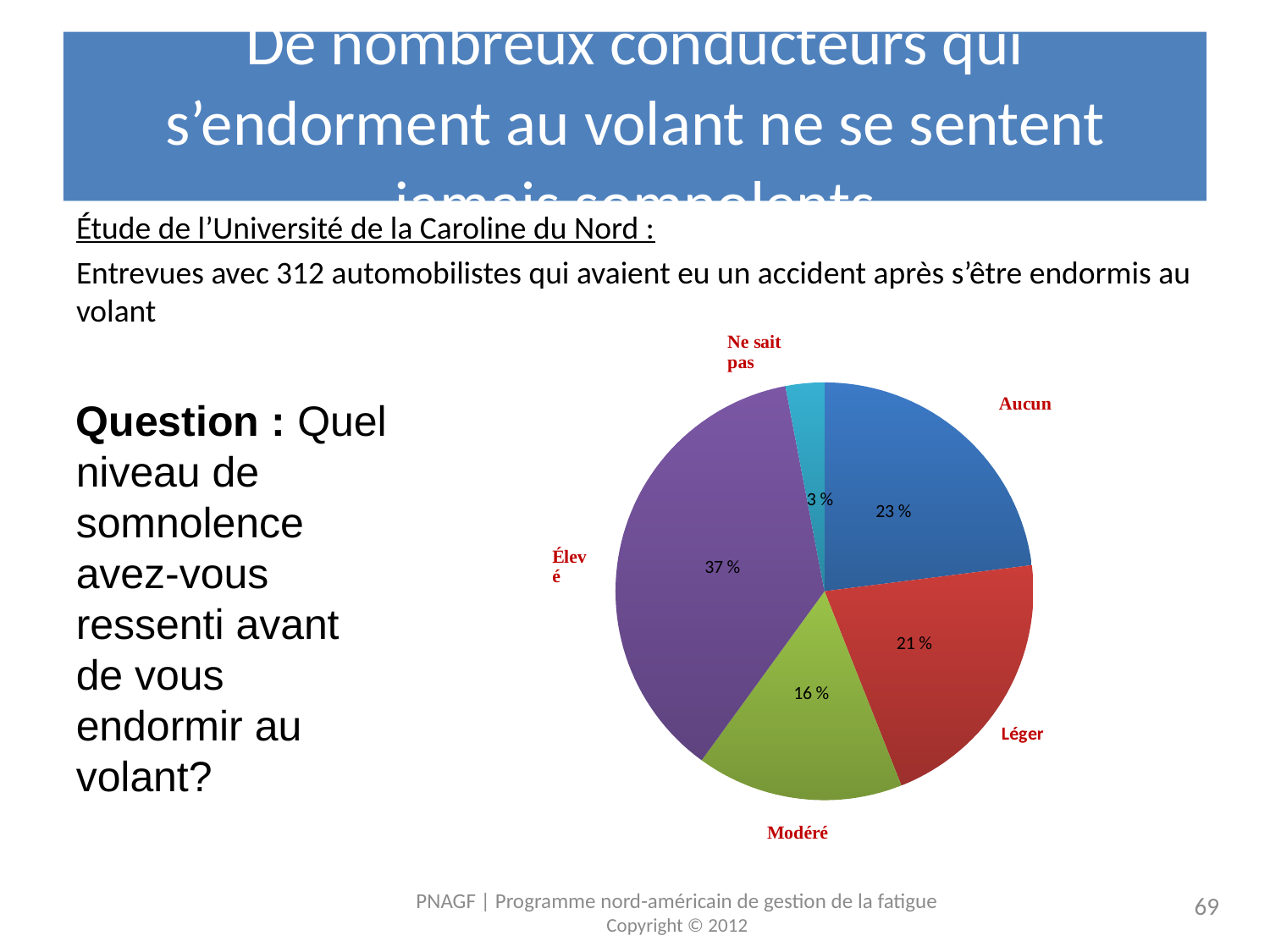
What percentage of the pie chart is labelled "Élevé"? 37 % Which category has the smallest slice of the pie chart? Ne sait pas What kind of chart is shown on the slide? pie chart How many slices does the pie chart have? 5 What colour is the "Élevé" slice of the pie chart? purple What percentage of the pie chart is labelled "Modéré"? 16 % What percentage of the pie chart is labelled "Aucun"? 23 % What is the difference in percentage points between the "Élevé" slice and the "Aucun" slice? 14 Which slice is larger, "Aucun" or "Modéré"? Aucun What percentage of the pie chart is labelled "Ne sait pas"? 3 % Which category has the largest slice of the pie chart? Élevé What percentage of the pie chart is labelled "Léger"? 21 %